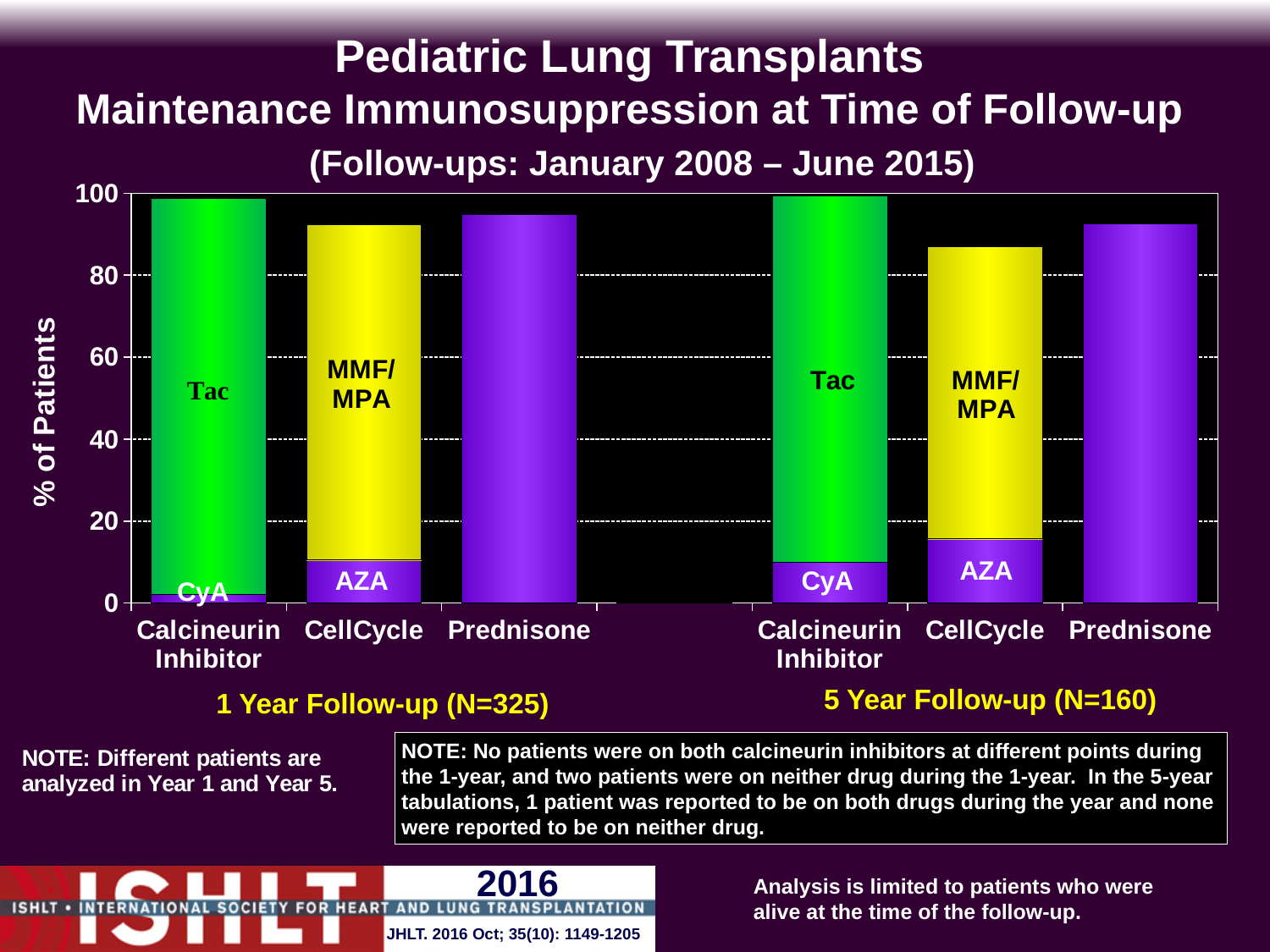
Which is larger: the CyA portion in the 1 Year Follow-up group or the CyA portion in the 5 Year Follow-up group? 5 Year Follow-up In the 5 Year Follow-up group, is the total value for CellCycle greater or less than 80? greater In the 5 Year Follow-up group, is the Tac portion of the Calcineurin Inhibitor bar greater or less than 80? greater In the 1 Year Follow-up group, which category has the lowest total bar height? CellCycle In the 5 Year Follow-up group, is the AZA portion of the CellCycle bar greater or less than 20? less How many drug categories are shown on the x axis for the 1 Year Follow-up group? 3 What kind of chart is shown on the slide? bar chart What is the N for the 1 Year Follow-up group? N=325 In the 5 Year Follow-up group, which category has the highest total bar height? Calcineurin Inhibitor What is the label on the y axis of the chart? % of Patients